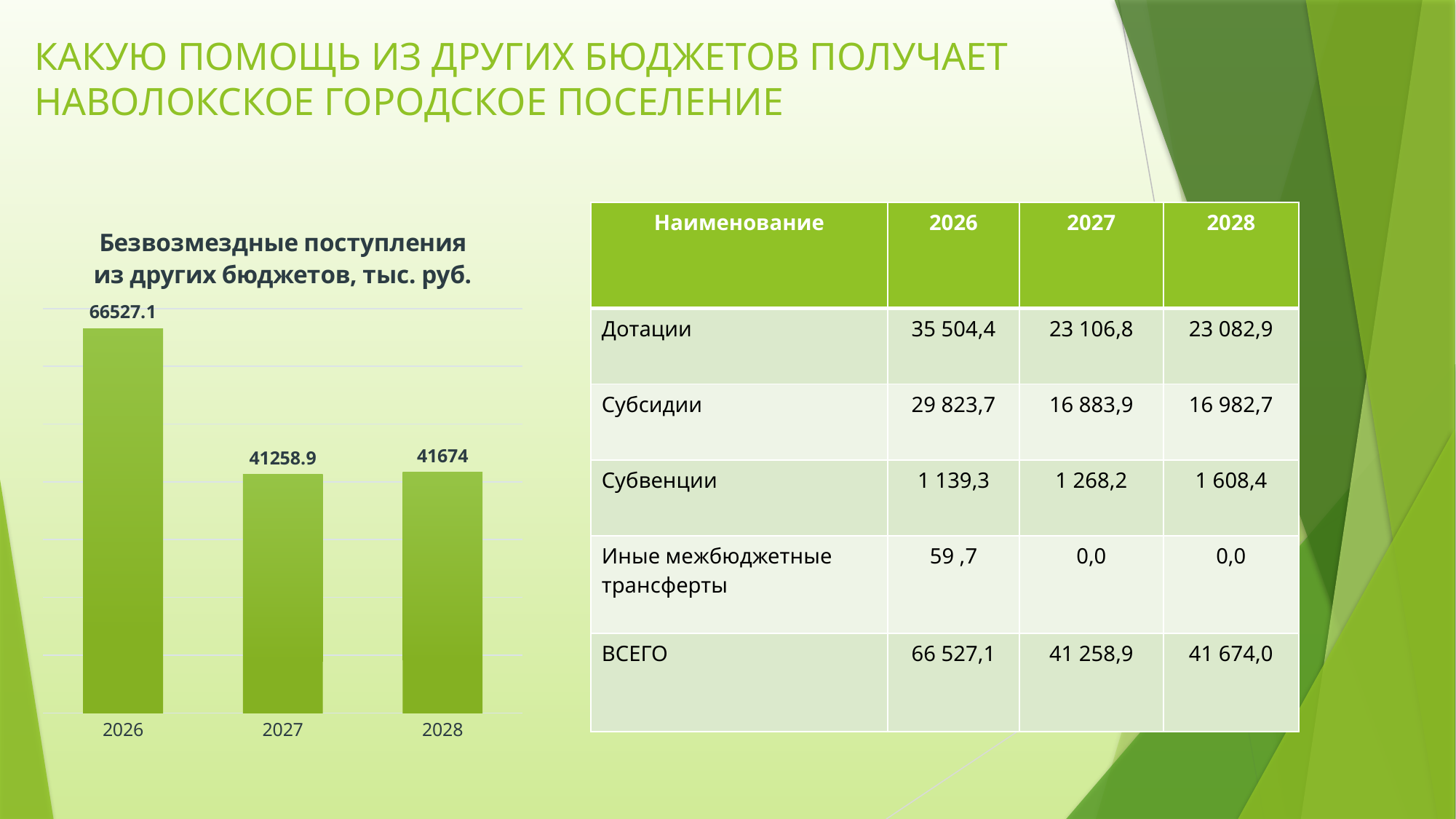
What is the value for 2026 in the chart? 66527.1 What is the difference between the values for 2026 and 2027? 25268.2 What is the title of the chart? Безвозмездные поступления из других бюджетов, тыс. руб. How many bars are shown in the chart? 3 What is the value for 2028 in the chart? 41674 Which year has the highest value in the chart? 2026 What kind of chart is shown on the slide? bar chart What is the difference between the values for 2028 and 2027? 415.1 Which is larger, the value for 2026 or the value for 2028? 2026 Do the values rise or fall from 2026 to 2027? fall What is the value for 2027 in the chart? 41258.9 Which year has the lowest value in the chart? 2027